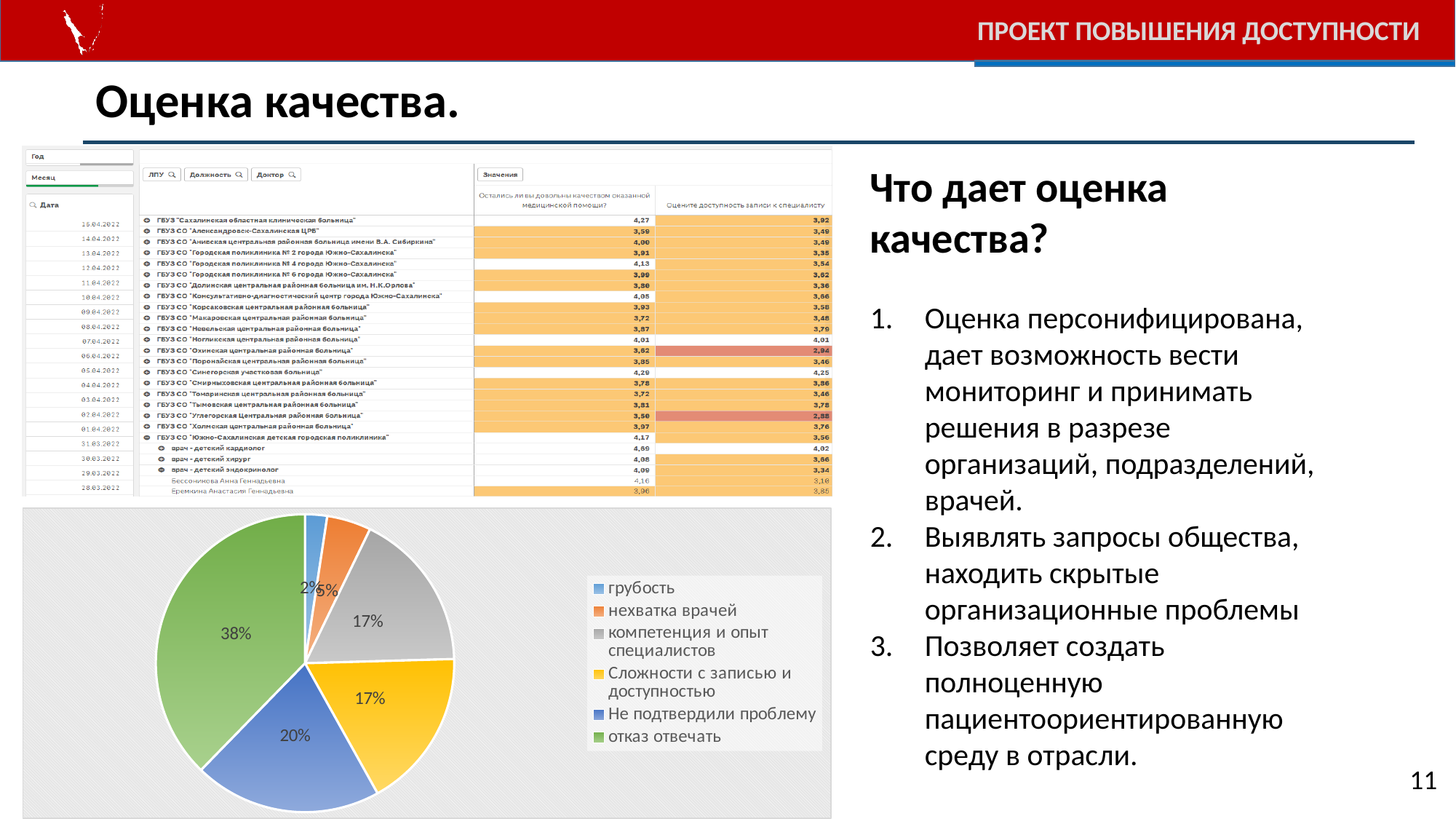
In the pie chart, by how many percentage points does "отказ отвечать" exceed "Не подтвердили проблему"? 18 percentage points In the pie chart, what share is labelled for "Сложности с записью и доступностью"? 17% In the pie chart, what share is labelled for "отказ отвечать"? 38% What colour is the "отказ отвечать" slice in the pie chart? green In the pie chart, what share is labelled for "компетенция и опыт специалистов"? 17% Which category has the smallest slice in the pie chart? грубость In the pie chart, what share is labelled for "Не подтвердили проблему"? 20% How many categories does the pie chart's legend list? 6 Which category has the largest slice in the pie chart? отказ отвечать In the pie chart, which is larger: "Не подтвердили проблему" or "компетенция и опыт специалистов"? Не подтвердили проблему In the pie chart, what share is labelled for "грубость"? 2% What kind of chart is shown in the lower left of the slide? pie chart